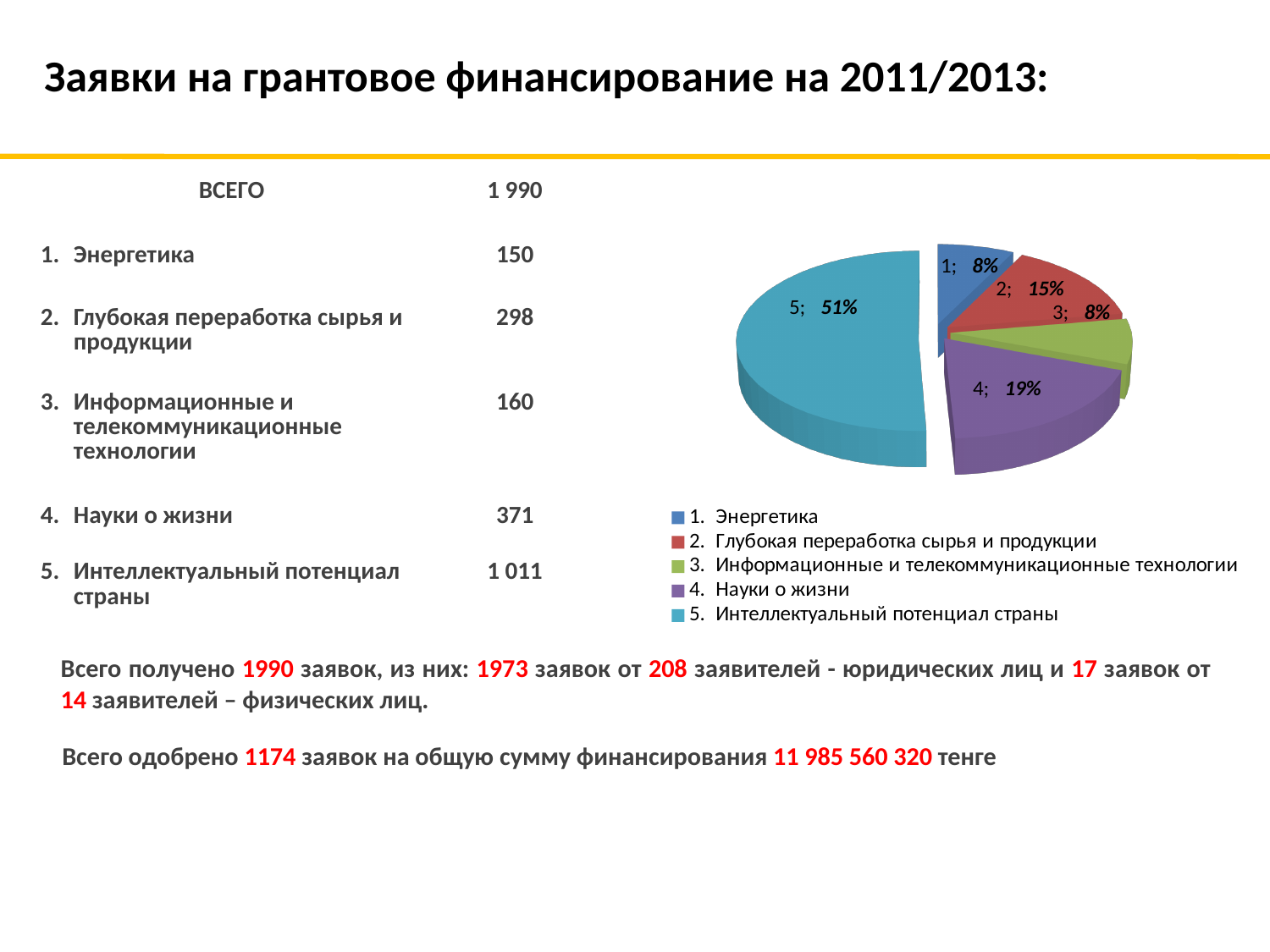
What type of chart is shown on the slide? pie chart What colour is the slice for category 4 (Науки о жизни) in the pie chart? purple Which category has the largest slice in the pie chart? 5. Интеллектуальный потенциал страны What percentage is shown for slice 3 (Информационные и телекоммуникационные технологии) in the pie chart? 8% What percentage is shown for slice 4 (Науки о жизни) in the pie chart? 19% Which slice is larger in the pie chart: slice 4 (Науки о жизни) or slice 2 (Глубокая переработка сырья и продукции)? 4. Науки о жизни What is the difference in percentage points between slice 5 (51%) and slice 4 (19%) in the pie chart? 32% How many slices does the pie chart have? 5 What percentage is shown for slice 1 (Энергетика) in the pie chart? 8% How many entries does the legend of the pie chart list? 5 What share of the pie does slice 5 (Интеллектуальный потенциал страны) represent? 51% What percentage is shown for slice 2 (Глубокая переработка сырья и продукции) in the pie chart? 15%